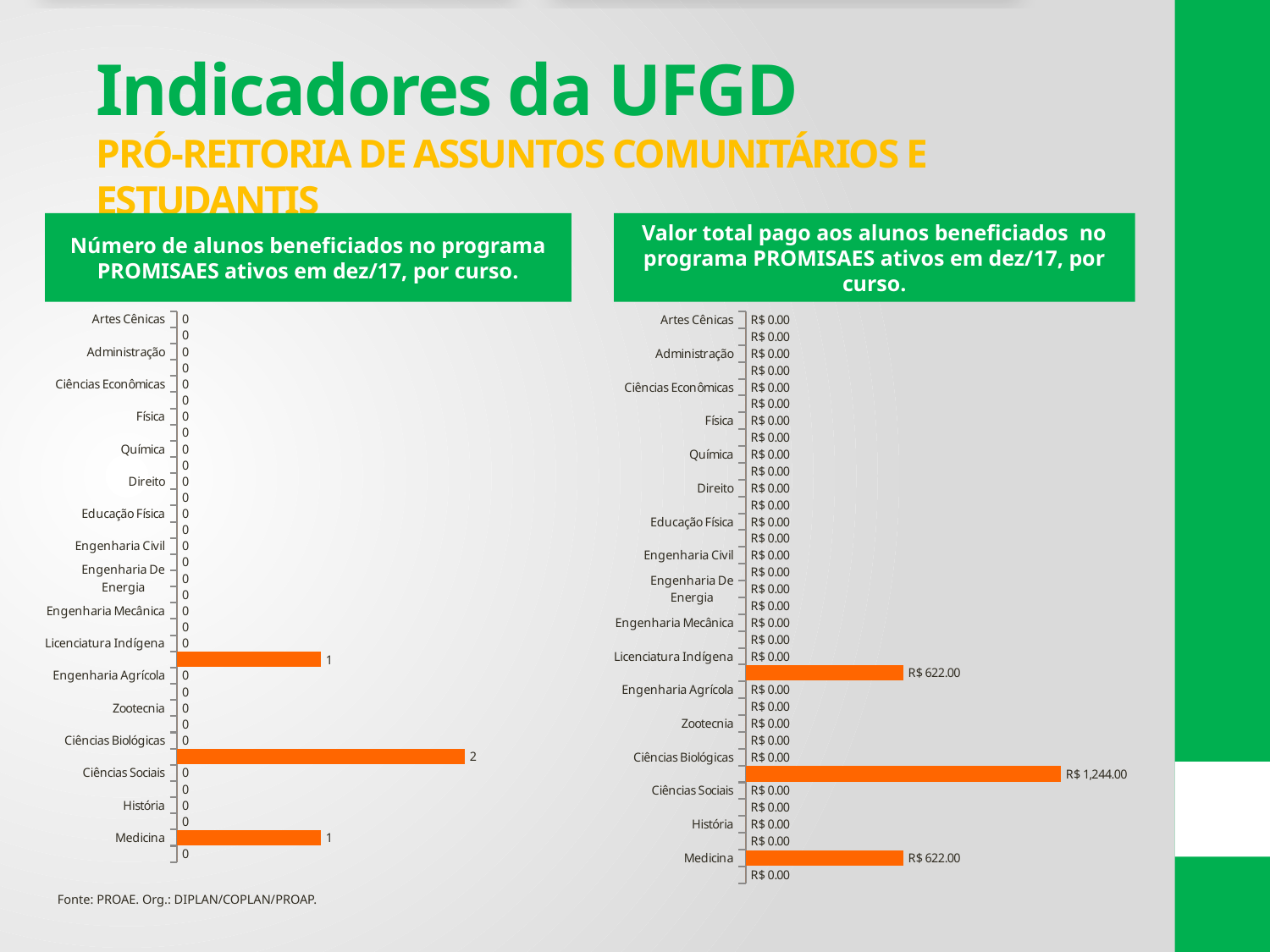
In the left chart (Número de alunos beneficiados), what is the value for Engenharia Mecânica? 0 In the right chart (Valor total pago aos alunos beneficiados), what is the value for Medicina? R$ 622.00 In the left chart (Número de alunos beneficiados), what is the value for Medicina? 1 What is the source cited at the bottom of the slide? Fonte: PROAE. Org.: DIPLAN/COPLAN/PROAP. In the right chart (Valor total pago aos alunos beneficiados), what is the largest value shown on any bar? R$ 1,244.00 In the right chart (Valor total pago aos alunos beneficiados), what is the value for Artes Cênicas? R$ 0.00 How many charts are shown on the slide? 2 In the left chart (Número de alunos beneficiados), is the value for Medicina larger or smaller than the value for Física? Larger In the left chart (Número de alunos beneficiados), what is the value for Ciências Sociais? 0 In the left chart (Número de alunos beneficiados), what is the largest value shown on any bar? 2 What kind of chart is the left chart, 'Número de alunos beneficiados no programa PROMISAES ativos em dez/17, por curso'? Bar chart In the right chart (Valor total pago aos alunos beneficiados), what is the difference between the largest bar value (R$ 1,244.00) and the value for Medicina? R$ 622.00